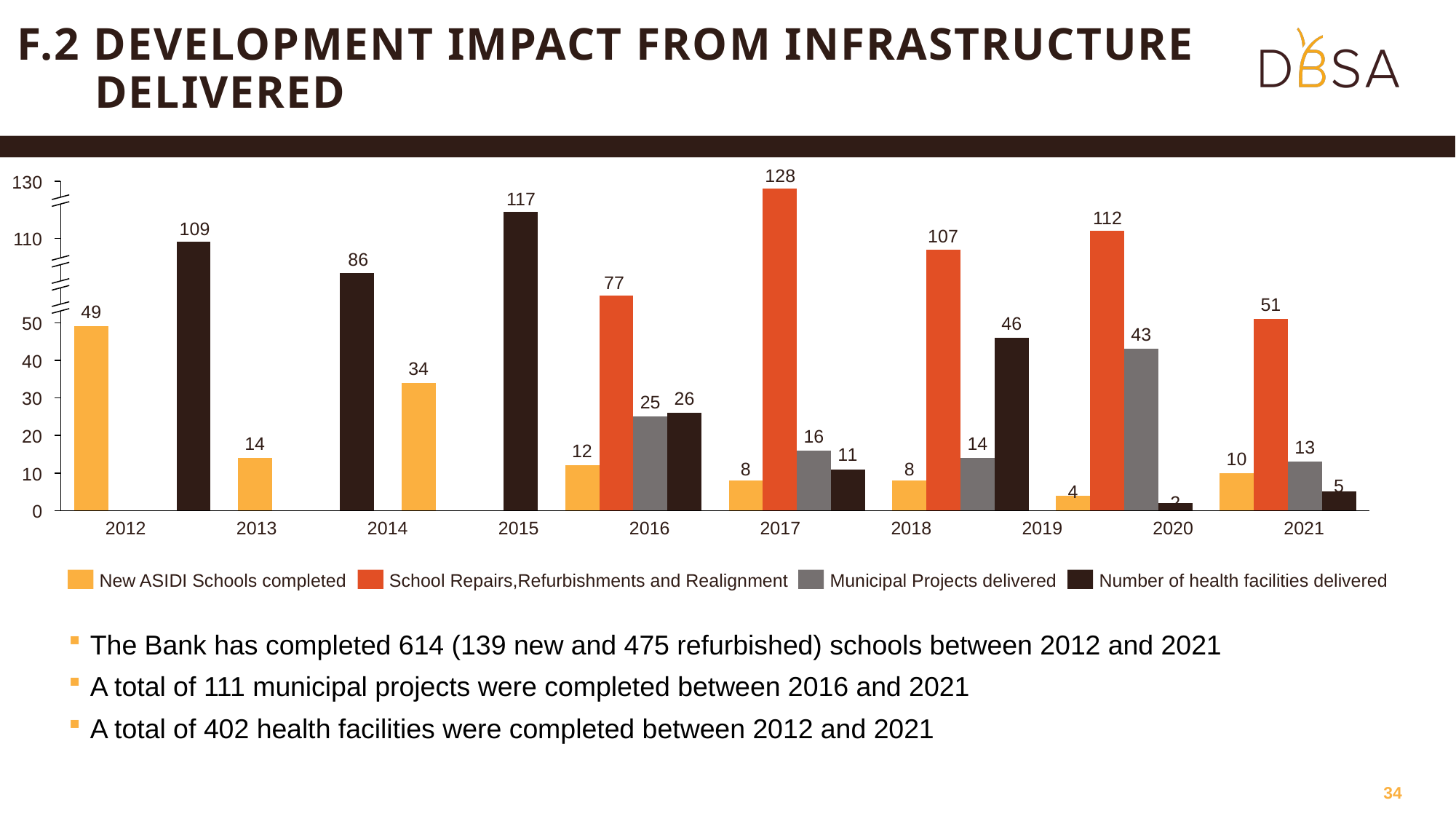
What is the highest value shown for Number of health facilities delivered? 117 How many years are shown on the x axis? 10 What is the value for School Repairs, Refurbishments and Realignment in 2021? 51 What is the value for New ASIDI Schools completed in 2012? 49 Which colour represents Municipal Projects delivered in the legend? grey In 2021, how much larger is the School Repairs, Refurbishments and Realignment value than the New ASIDI Schools completed value? 41 What is the value for Municipal Projects delivered in 2021? 13 What is the highest value shown for School Repairs, Refurbishments and Realignment? 128 What is the lowest value shown for Number of health facilities delivered? 2 What kind of chart is shown on the slide? bar chart How many series does the legend list? 4 What is the highest value shown for Municipal Projects delivered? 43